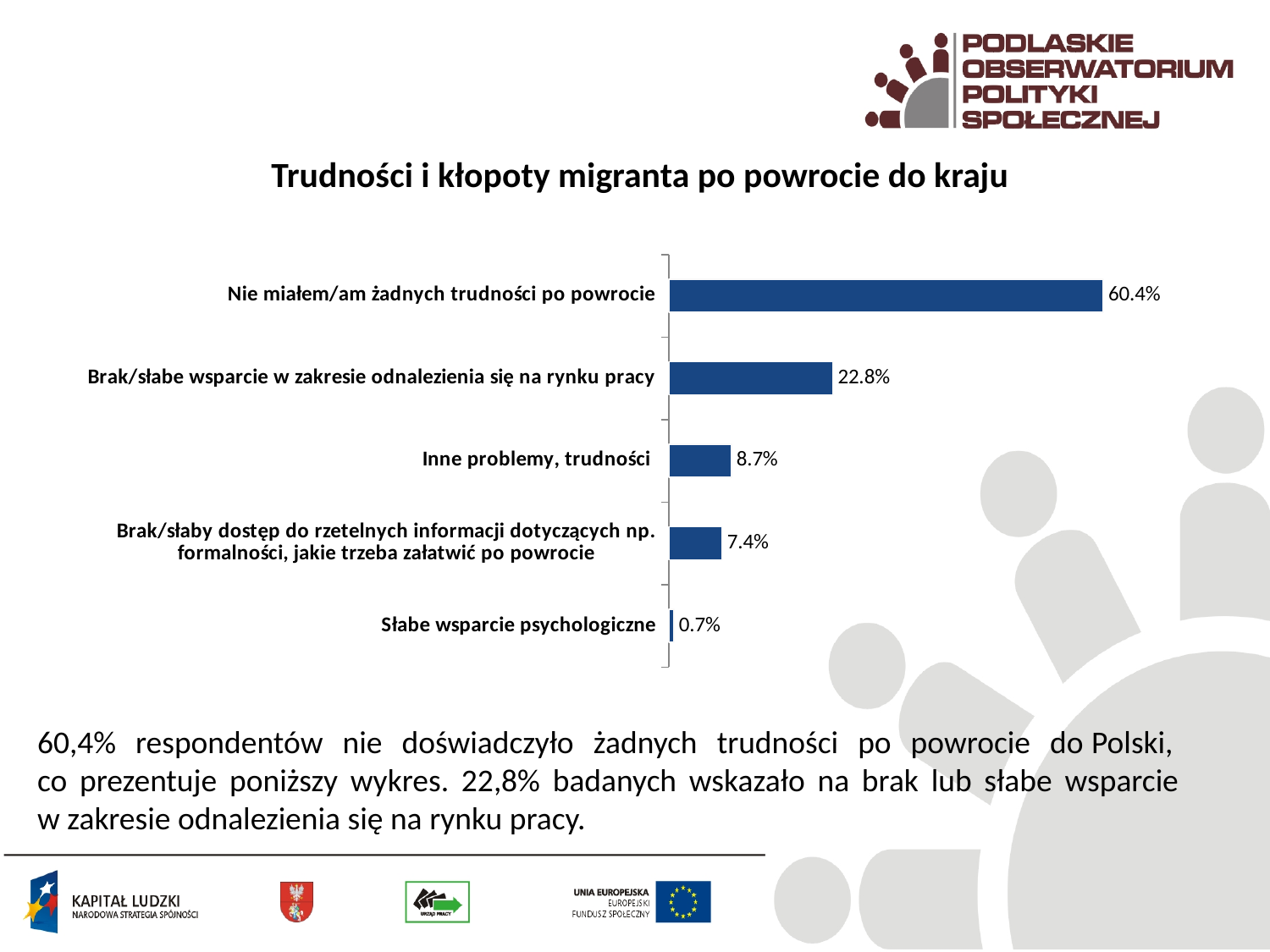
What value is shown for "Nie miałem/am żadnych trudności po powrocie"? 60.4% Which category has the highest value? Nie miałem/am żadnych trudności po powrocie What value is shown for "Brak/słabe wsparcie w zakresie odnalezienia się na rynku pracy"? 22.8% What value is shown for "Słabe wsparcie psychologiczne"? 0.7% What value is shown for "Inne problemy, trudności"? 8.7% What is the difference between the values for "Inne problemy, trudności" and "Brak/słaby dostęp do rzetelnych informacji dotyczących np. formalności, jakie trzeba załatwić po powrocie"? 1.3% What is the difference between the values for "Nie miałem/am żadnych trudności po powrocie" and "Brak/słabe wsparcie w zakresie odnalezienia się na rynku pracy"? 37.6% How many categories are shown in the chart? 5 What kind of chart is shown on the slide? Bar chart Which category has the lowest value? Słabe wsparcie psychologiczne What is the title of the chart? Trudności i kłopoty migranta po powrocie do kraju Which is larger: the value for "Inne problemy, trudności" or for "Słabe wsparcie psychologiczne"? Inne problemy, trudności